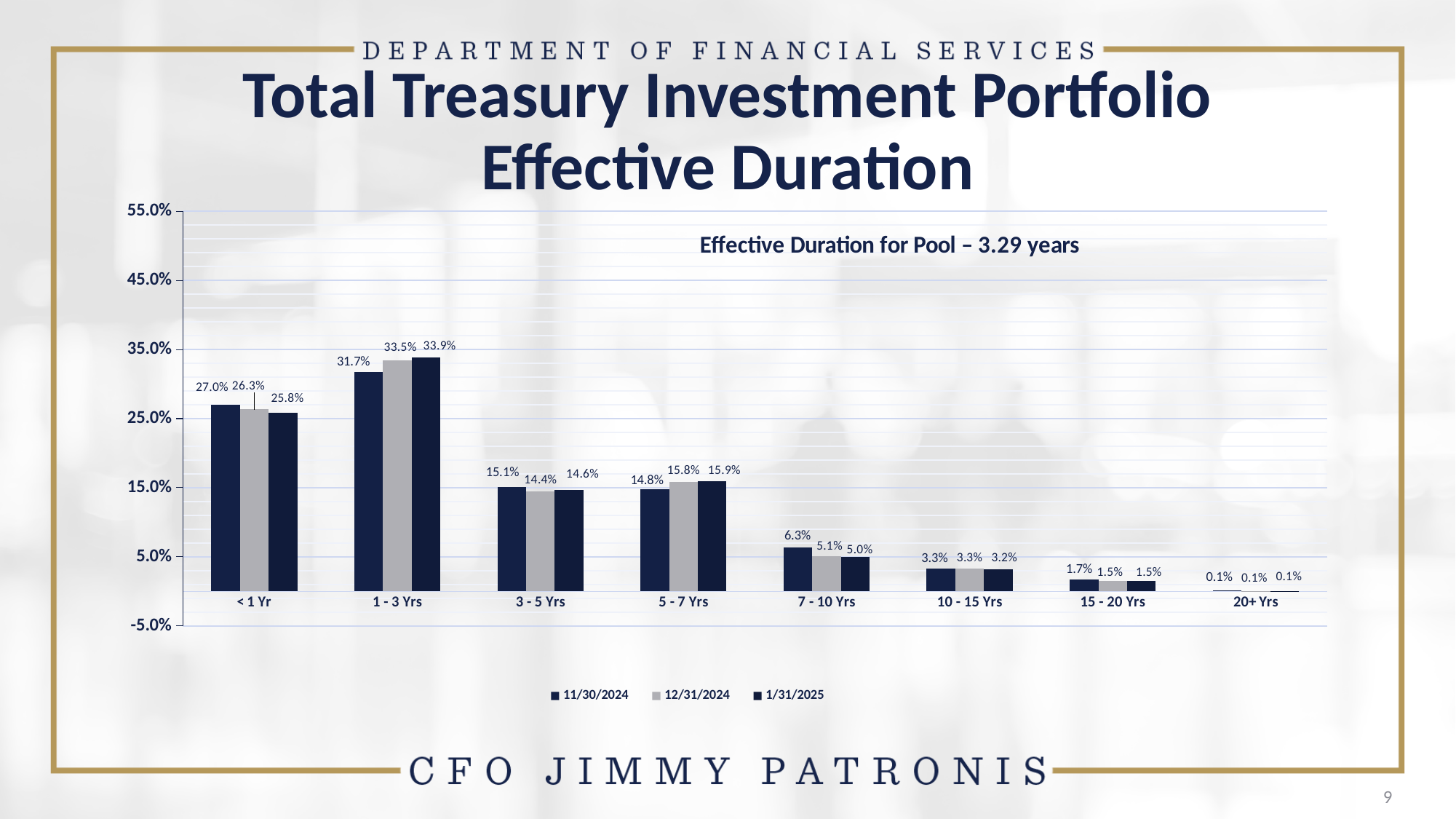
Which category has the lowest value in the 11/30/2024 series? 20+ Yrs What is the value for the < 1 Yr category in the 11/30/2024 series? 27.0% What is the value for the 7 - 10 Yrs category in the 12/31/2024 series? 5.1% What is the difference between the 1/31/2025 and 11/30/2024 values for the 1 - 3 Yrs category? 2.2% What kind of chart is shown on the slide? Bar chart Do the values in the 12/31/2024 series rise or fall from the 1 - 3 Yrs category to the 20+ Yrs category? Fall What effective duration for the pool is stated on the chart? 3.29 years How many series does the legend list? 3 Which category has the highest value in the 1/31/2025 series? 1 - 3 Yrs How many categories are shown on the x axis? 8 What is the value for the 1 - 3 Yrs category in the 1/31/2025 series? 33.9% For the < 1 Yr category, which series has the larger value: 11/30/2024 or 1/31/2025? 11/30/2024